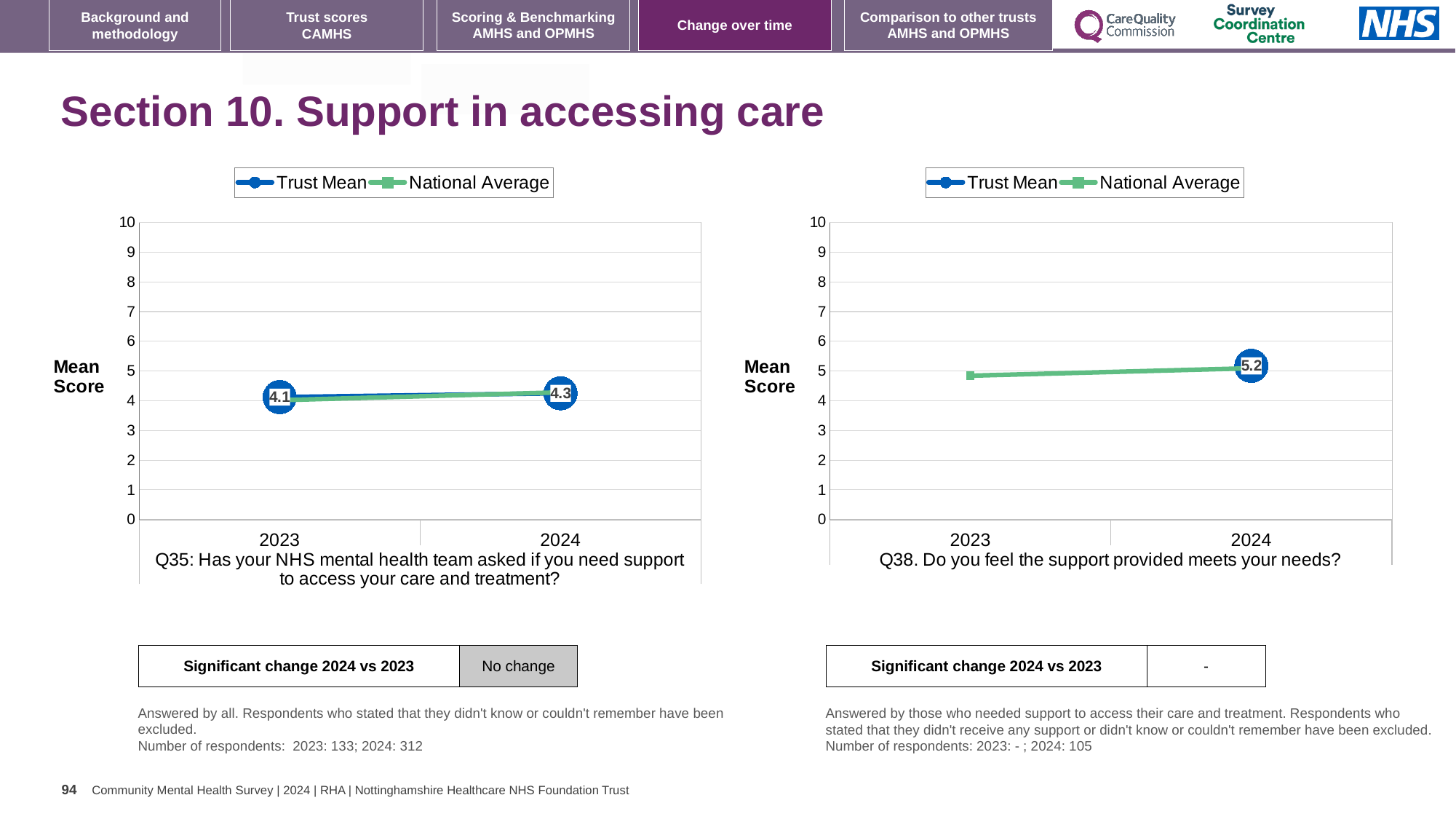
In the Q35 chart on the left, what is the Trust Mean for 2024? 4.3 How many years are shown on the x axis of the Q35 chart on the left? 2 In the Q38 chart on the right, what is the Trust Mean for 2024? 5.2 In the Q35 chart on the left, is the Trust Mean for 2024 greater or less than 5? less What kind of chart is the Q35 chart on the left? line chart What is the y-axis label of the Q38 chart on the right? Mean Score How many series does the legend of the Q38 chart on the right list? 2 In the Q35 chart on the left, which year has the higher Trust Mean? 2024 In the Q38 chart on the right, is the National Average for 2023 greater or less than 6? less In the Q35 chart on the left, what is the Trust Mean for 2023? 4.1 In the Q35 chart on the left, by how much did the Trust Mean change from 2023 to 2024? 0.2 In the Q35 chart on the left, does the Trust Mean rise or fall from 2023 to 2024? rise